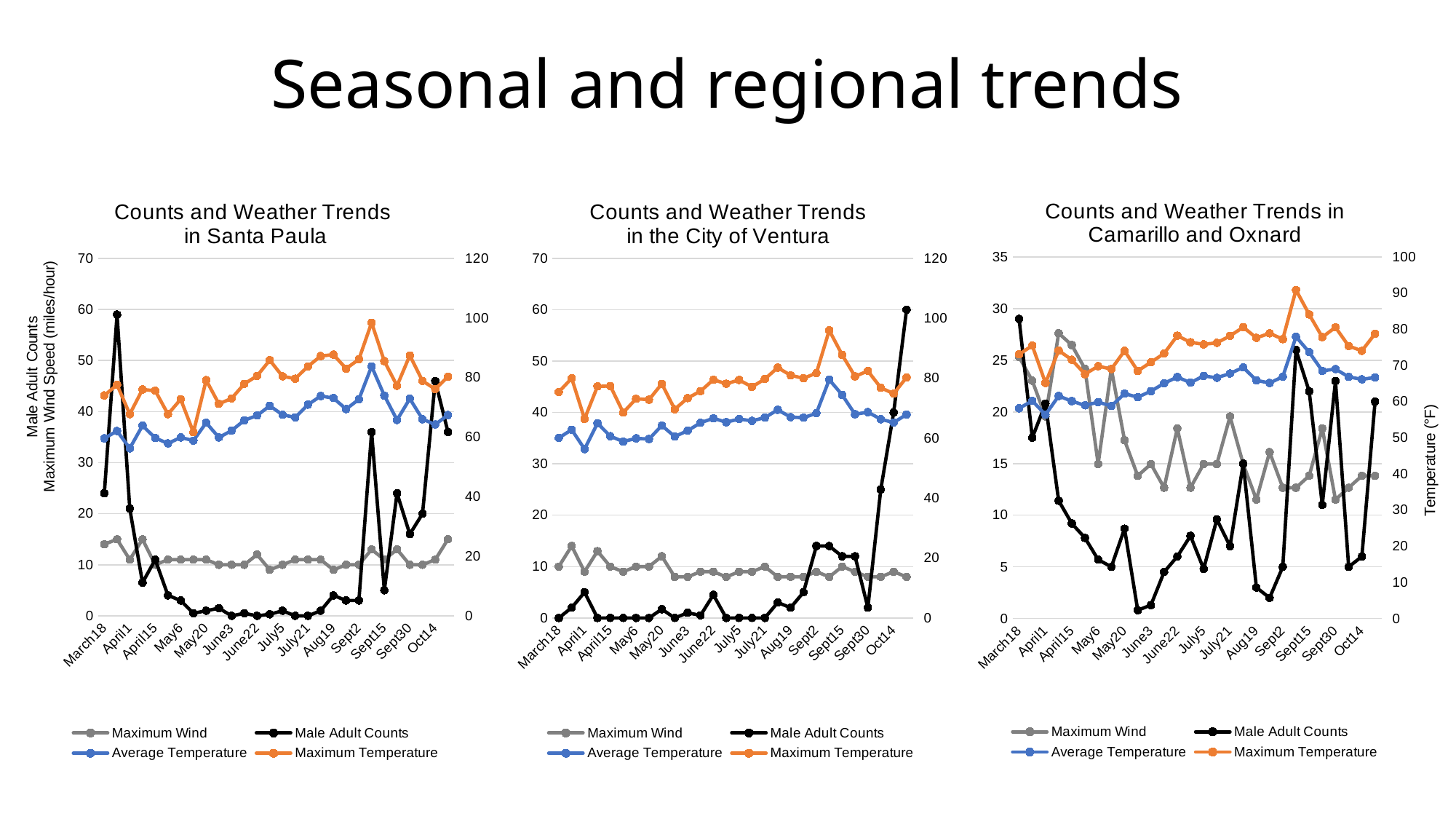
What is the label of the right-hand vertical axis on the 'Counts and Weather Trends in Camarillo and Oxnard' chart? Temperature (°F) In the 'Counts and Weather Trends in Santa Paula' chart, is the Male Adult Counts value at April1 greater or less than 50? less In the 'Counts and Weather Trends in the City of Ventura' chart, does Male Adult Counts rise or fall from Sept30 to Oct14? rise What kind of chart is the 'Counts and Weather Trends in Santa Paula' chart? line chart In the 'Counts and Weather Trends in Santa Paula' chart, which is larger: Male Adult Counts at April1 or at Sept2? April1 In the 'Counts and Weather Trends in Santa Paula' chart, is the Maximum Temperature at Sept15 greater or less than 90? less How many series does the legend of the 'Counts and Weather Trends in the City of Ventura' chart list? 4 In the 'Counts and Weather Trends in the City of Ventura' chart, is the Male Adult Counts value at Oct14 greater or less than 50? less